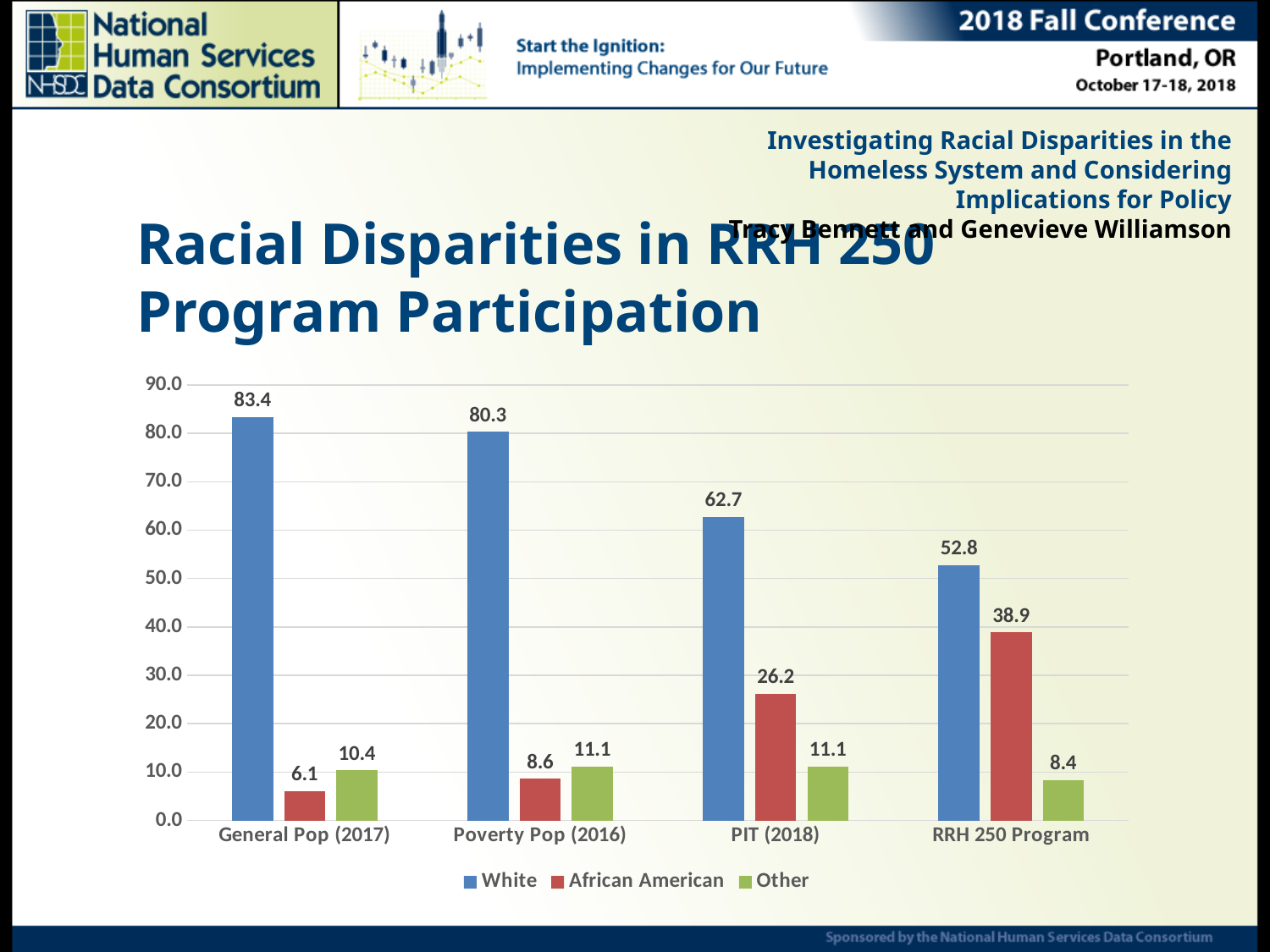
Is the White value for PIT (2018) greater or less than 60.0? greater Which is larger: the African American value for PIT (2018) or the African American value for Poverty Pop (2016)? PIT (2018) Which category has the highest value for African American? RRH 250 Program Which category has the lowest value for White? RRH 250 Program What is the difference between the White value for General Pop (2017) and the White value for RRH 250 Program? 30.6 Which colour represents the African American series in the legend? Red What is the value for Other in the PIT (2018) category? 11.1 How many series does the legend list? 3 How many categories are shown on the x axis? 4 What kind of chart is shown on the slide? Bar chart What is the value for White in the General Pop (2017) category? 83.4 What is the value for African American in the RRH 250 Program category? 38.9